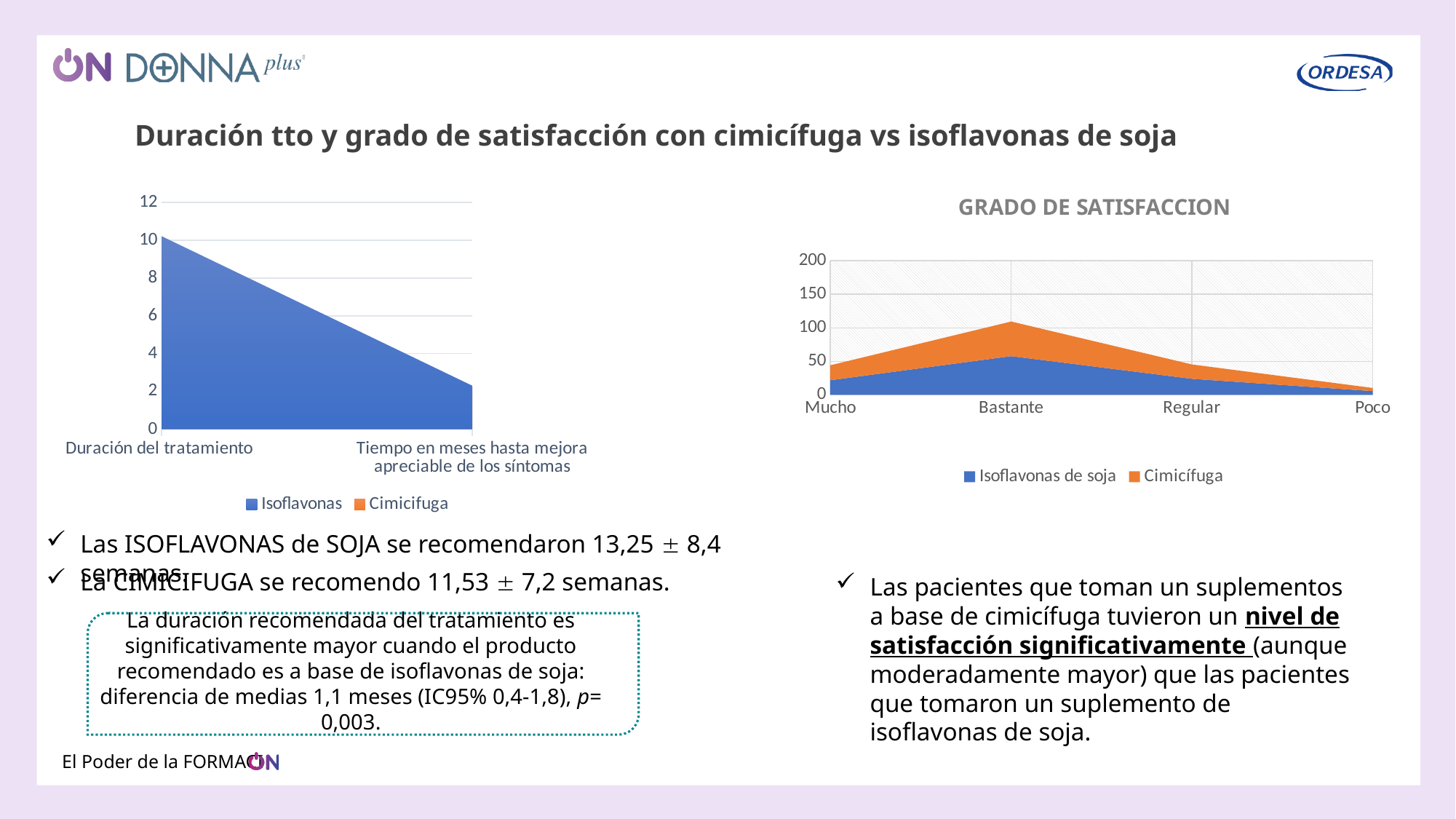
In the GRADO DE SATISFACCION chart, which category has the highest stacked total? Bastante In the GRADO DE SATISFACCION chart, is the stacked total for Poco greater or less than 50? less In the chart on the left of the slide, which two series does the legend list? Isoflavonas and Cimicifuga In the chart on the left of the slide, is the value for Duración del tratamiento greater or less than 8? greater In the GRADO DE SATISFACCION chart, is the stacked total for Bastante greater or less than 50? greater In the GRADO DE SATISFACCION chart, which category has the lowest stacked total? Poco In the GRADO DE SATISFACCION chart, how many categories are shown on the x axis? 4 In the GRADO DE SATISFACCION chart, how many series does the legend list? 2 In the chart on the left of the slide, which category has the larger value: Duración del tratamiento or Tiempo en meses hasta mejora apreciable de los síntomas? Duración del tratamiento What kind of chart is the GRADO DE SATISFACCION chart? area chart In the GRADO DE SATISFACCION chart, do the stacked totals rise or fall from Bastante to Poco? fall What is the title of the chart on the right of the slide? GRADO DE SATISFACCION